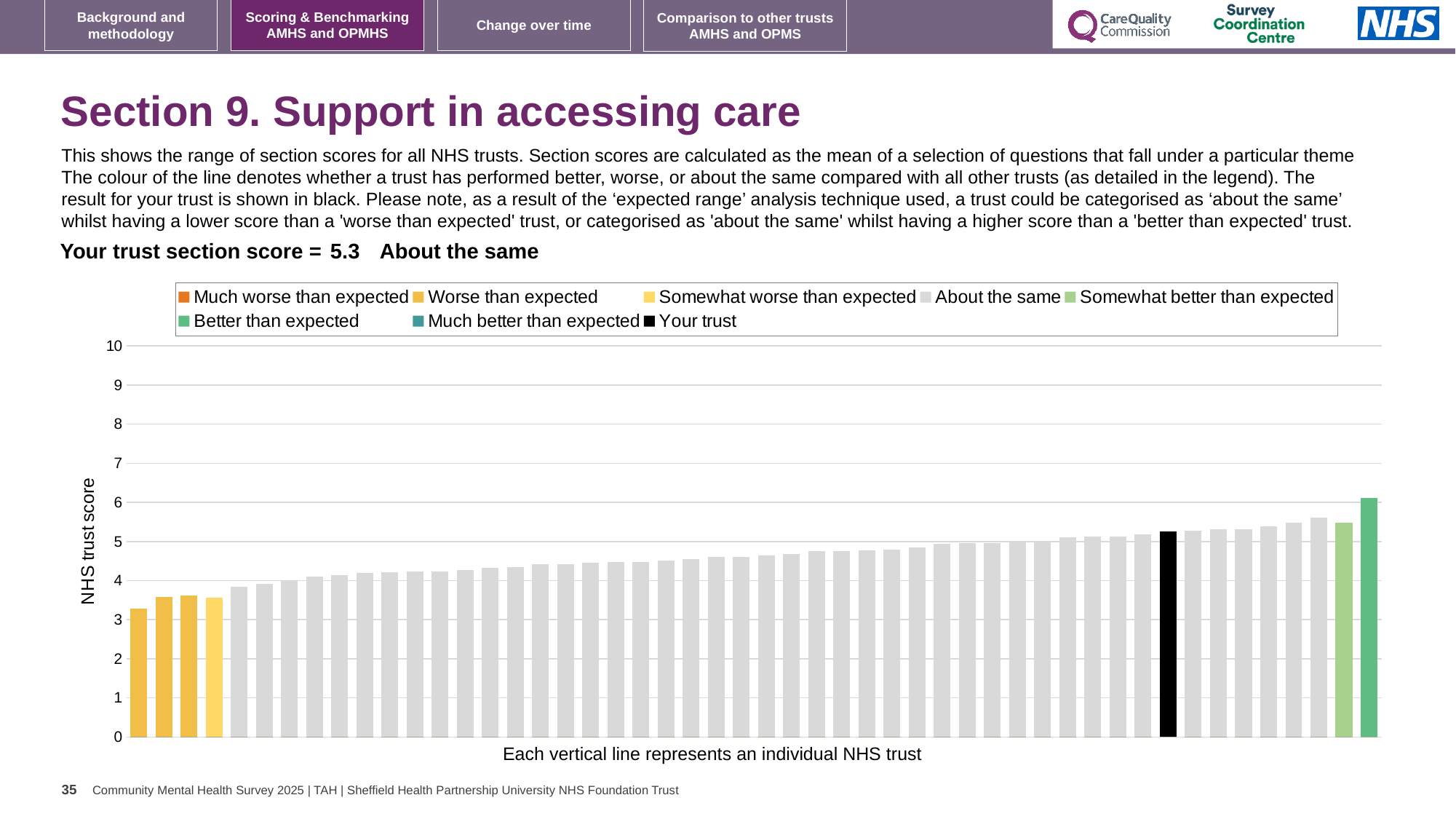
How many entries does the chart legend list? 8 What is the section score for your trust shown on the slide? 5.3 Which performance category is your trust placed in for this section? About the same What kind of chart is shown on the slide? bar chart Which is larger: the rightmost bar or the black bar for your trust? the rightmost bar Is the highest bar in the chart greater or less than 7? less What is the label on the vertical axis of the chart? NHS trust score Is the value of the black bar (your trust) greater or less than 5? greater Is the value of the rightmost bar greater or less than 6? greater Do the bar values rise or fall from left to right along the x axis? rise What does the caption below the chart say each vertical line represents? an individual NHS trust